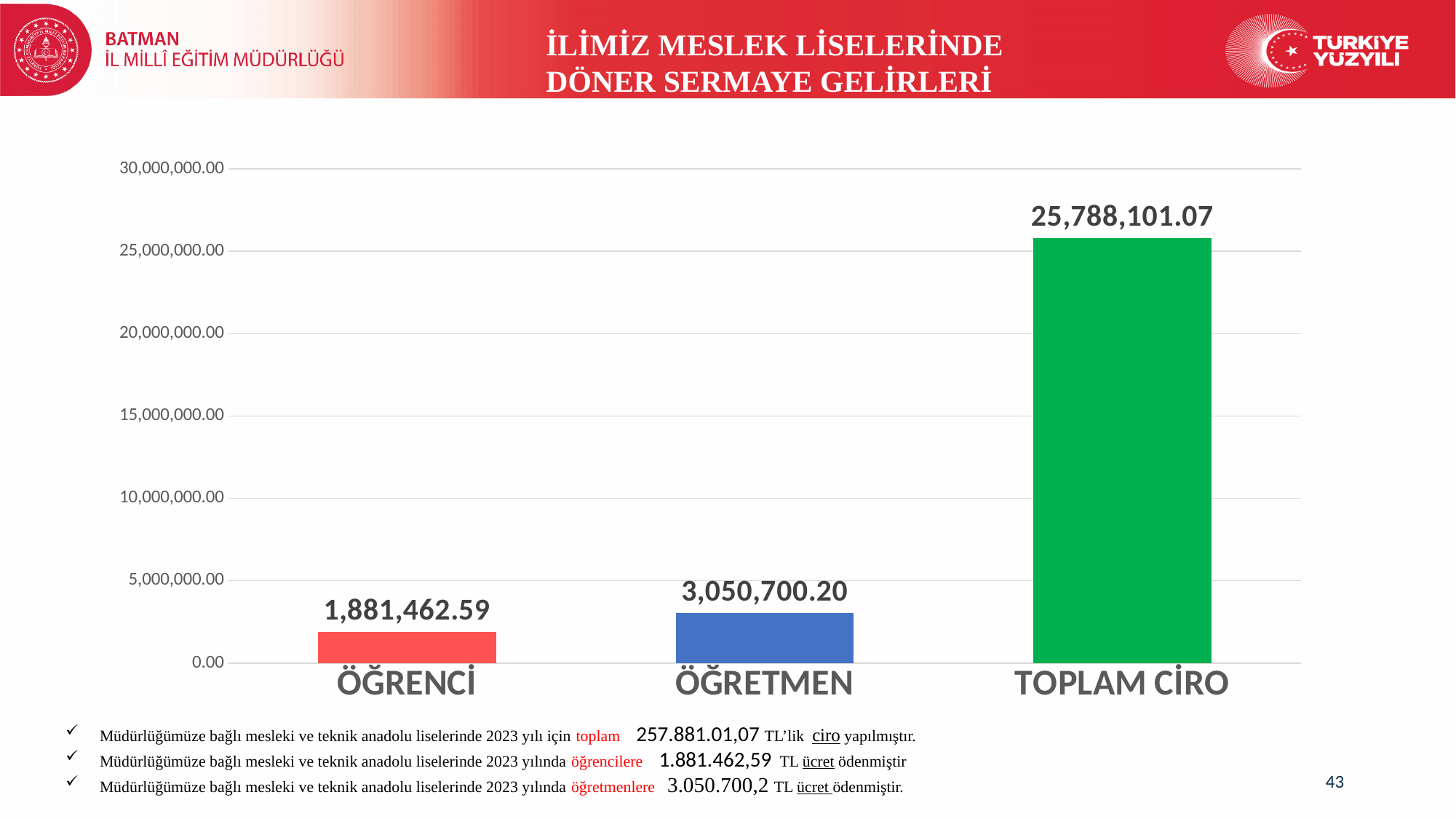
What is the value shown for ÖĞRENCİ? 1,881,462.59 What is the difference between the values for ÖĞRETMEN and ÖĞRENCİ? 1,169,237.61 Which is larger, the value for ÖĞRENCİ or the value for ÖĞRETMEN? ÖĞRETMEN What is the difference between the values for TOPLAM CİRO and ÖĞRETMEN? 22,737,400.87 Which category has the highest value? TOPLAM CİRO Is the value for ÖĞRETMEN greater or less than 5,000,000.00? less Is the value for TOPLAM CİRO greater or less than 25,000,000.00? greater Which category has the lowest value? ÖĞRENCİ What is the value shown for TOPLAM CİRO? 25,788,101.07 How many categories are shown in the chart? 3 What is the value shown for ÖĞRETMEN? 3,050,700.20 What kind of chart is shown on the slide? bar chart